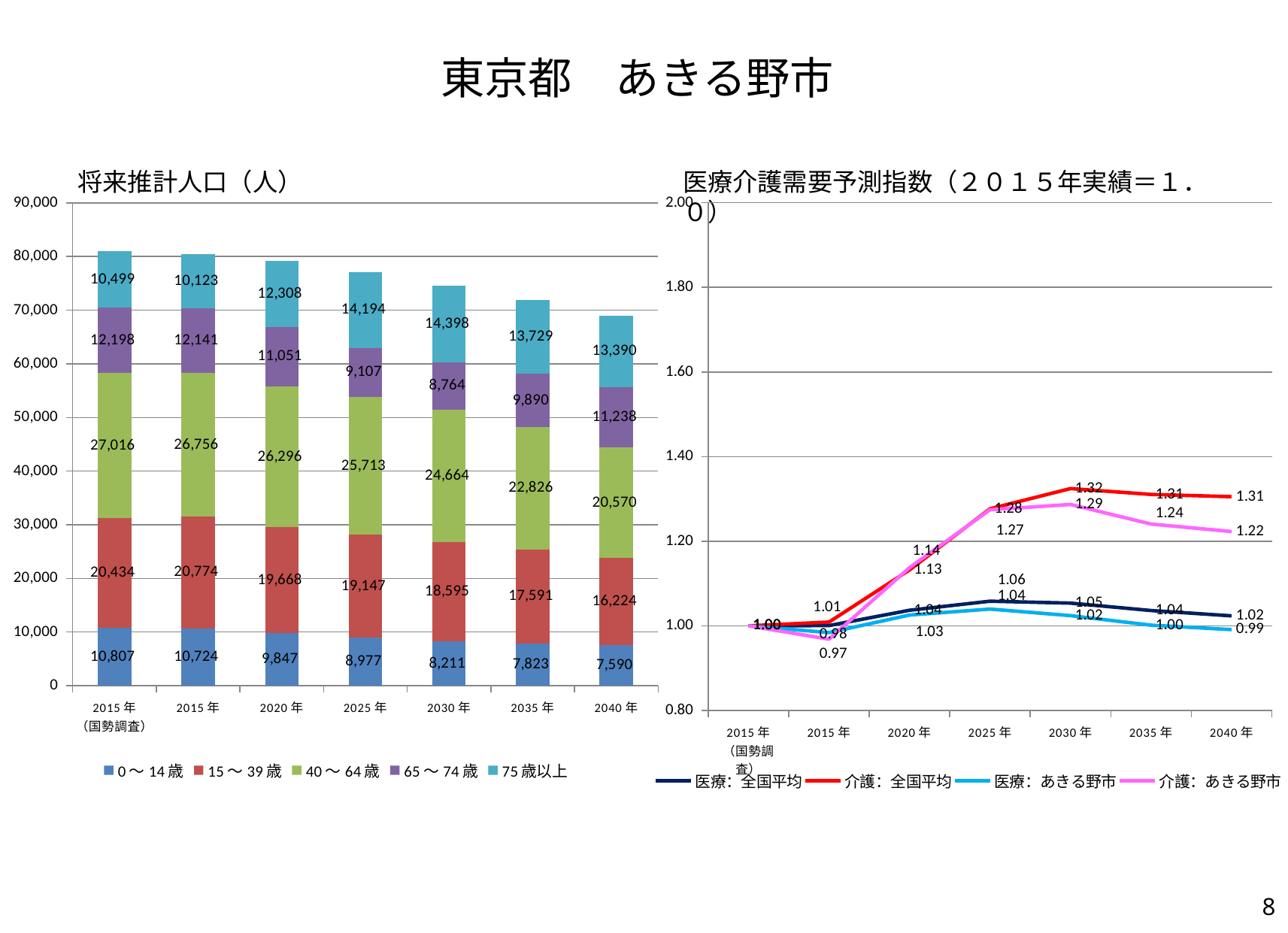
In the right chart (医療介護需要予測指数), what is the value for 介護：全国平均 in 2030年? 1.32 In the left chart (将来推計人口), what is the value for 0～14歳 in 2040年? 7,590 In the right chart (医療介護需要予測指数), how many series does the legend list? 4 In the right chart (医療介護需要予測指数), what is the value for 医療：あきる野市 in 2040年? 0.99 In the left chart (将来推計人口), what is the value for 40～64歳 in 2025年? 25,713 In the left chart (将来推計人口), what is the value for 75歳以上 in 2030年? 14,398 In the left chart (将来推計人口), what is the total of the stacked bar for 2040年? 69,012 In the left chart (将来推計人口), what is the difference between the 15～39歳 values for 2015年 and 2040年? 4,550 In the left chart (将来推計人口), how many series does the legend list? 5 In the right chart (医療介護需要予測指数), which is larger in 2040年: 介護：全国平均 or 介護：あきる野市? 介護：全国平均 In the left chart (将来推計人口), what kind of chart is it? Stacked bar chart In the left chart (将来推計人口), which year has the lowest value for 40～64歳? 2040年